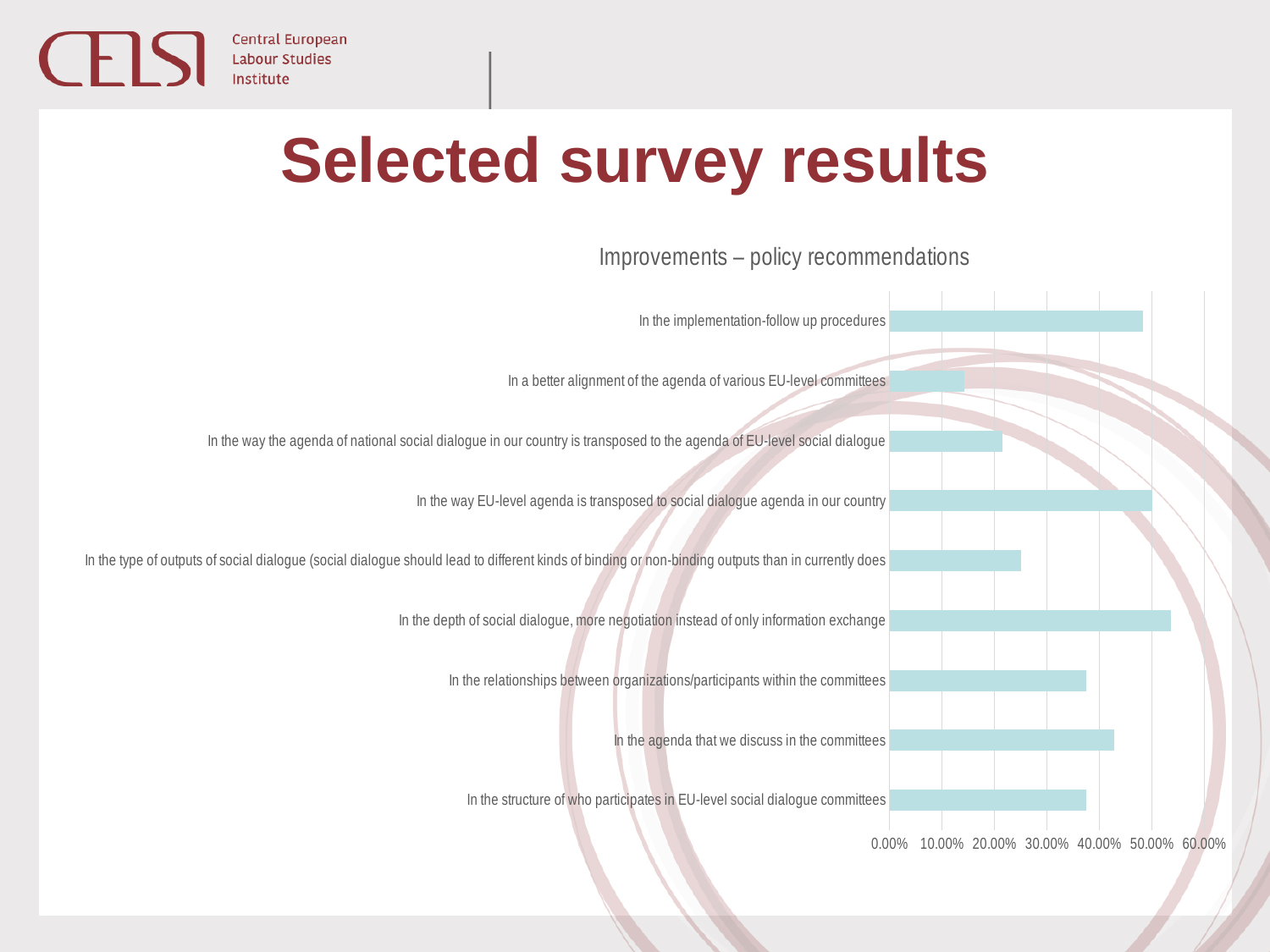
What kind of chart is shown on the slide? Bar chart Which is larger: the value for "In the agenda that we discuss in the committees" or for "In the relationships between organizations/participants within the committees"? In the agenda that we discuss in the committees Which is larger: the value for "In the implementation-follow up procedures" or for "In a better alignment of the agenda of various EU-level committees"? In the implementation-follow up procedures Is the value for "In a better alignment of the agenda of various EU-level committees" greater or less than 20.00%? less Which category has the lowest value? In a better alignment of the agenda of various EU-level committees Is the value for "In the type of outputs of social dialogue" greater or less than 30.00%? less Is the value for "In the structure of who participates in EU-level social dialogue committees" greater or less than 40.00%? less Which category has the highest value? In the depth of social dialogue, more negotiation instead of only information exchange How many categories are plotted in the chart? 9 What is the title of the chart? Improvements – policy recommendations